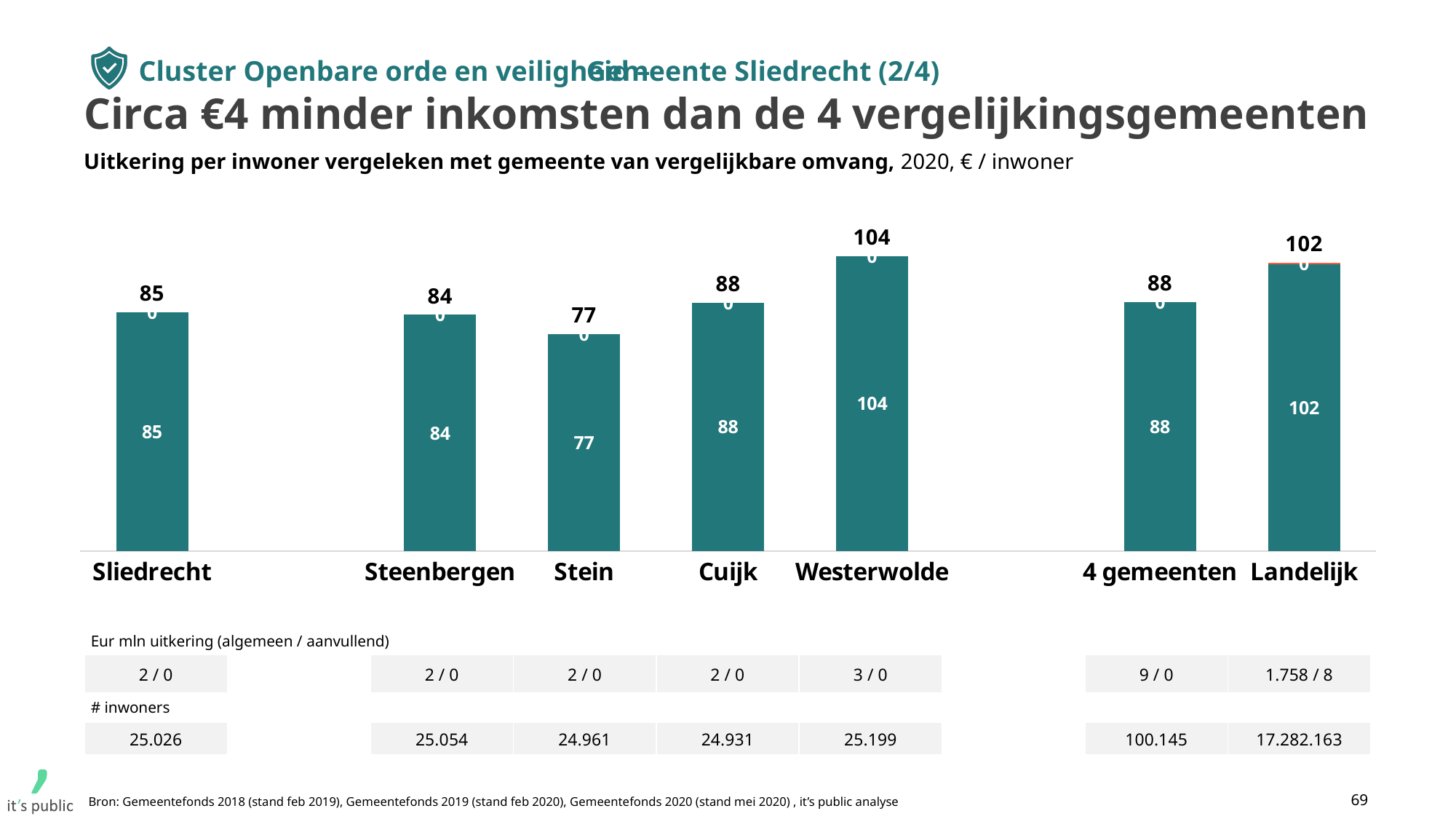
Which category has the highest value? Westerwolde Which is larger, the value for Cuijk or the value for Steenbergen? Cuijk What is the value for Westerwolde? 104 What is the value for Landelijk? 102 What is the value for Stein? 77 What kind of chart is shown on the slide? Bar chart What is the difference between the values for 4 gemeenten and Stein? 11 What unit is stated in the chart subtitle for the values? € / inwoner What is the difference between the values for Westerwolde and Sliedrecht? 19 Which category has the lowest value? Stein What is the value for Sliedrecht? 85 How many categories are shown on the x axis of the chart? 7